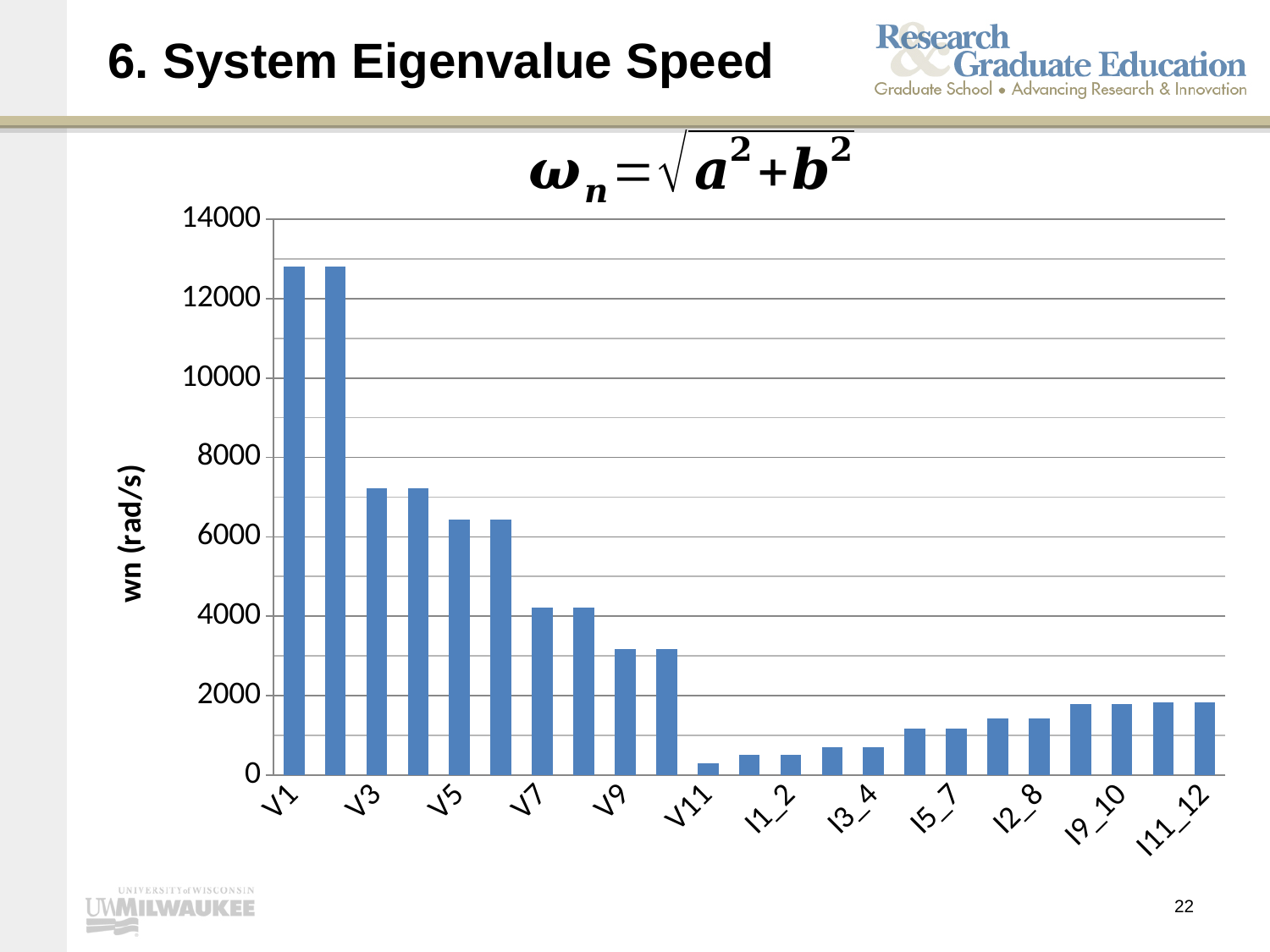
Is the value for V3 greater or less than 8000? less Do the values rise or fall from V1 to V11 along the x axis? fall Which labelled category has the lowest value? V11 Is the value for V5 greater or less than 6000? greater Which has a larger value, V9 or I5_7? V9 Is the value for V1 greater or less than 12000? greater How many bars are plotted in the chart? 23 What is the label of the vertical axis? wn (rad/s) Which has a larger value, I1_2 or I9_10? I9_10 What kind of chart is shown on the slide? bar chart